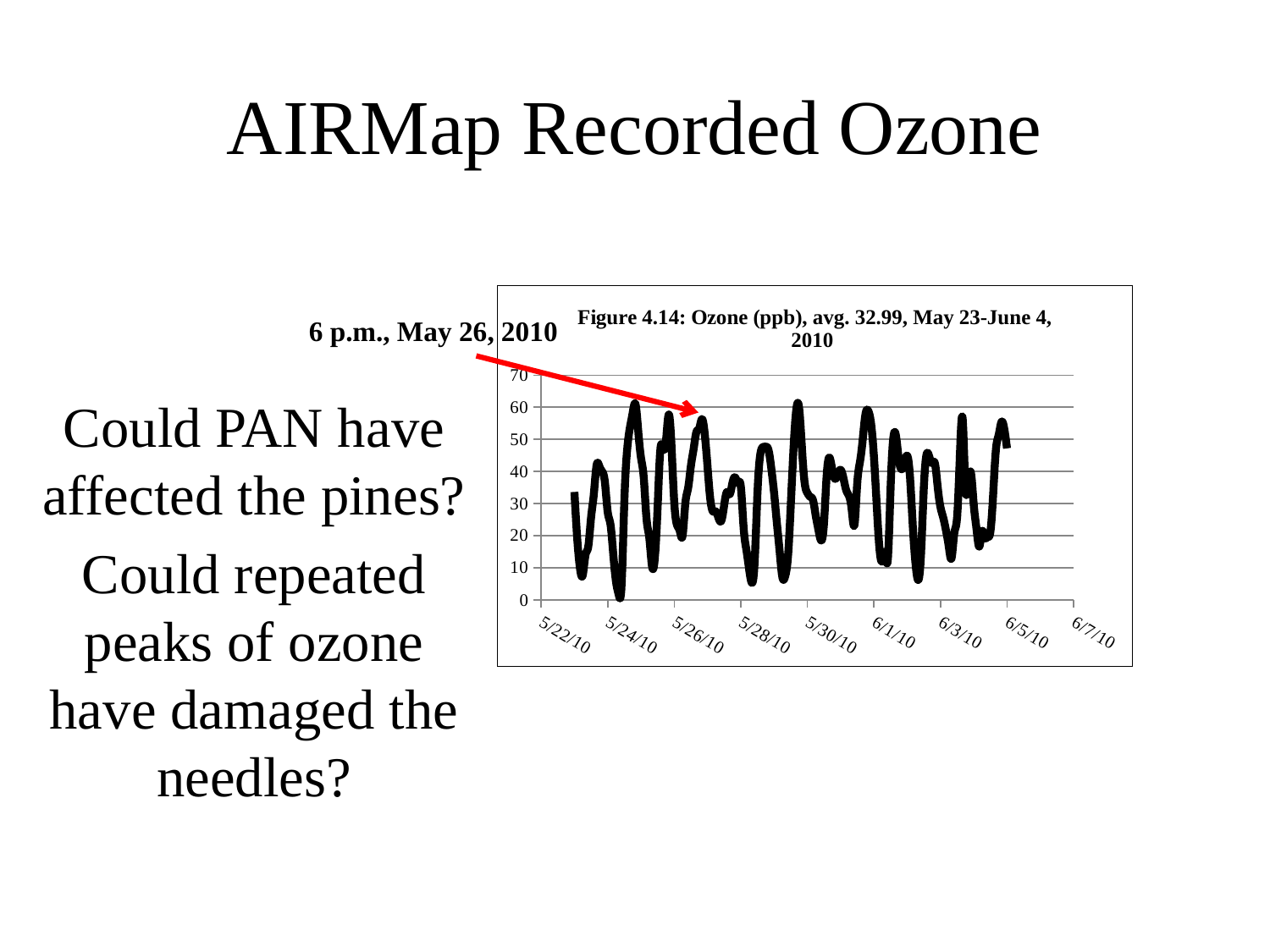
Is the highest ozone peak on the chart greater or less than 50? greater What is the first date label on the x axis? 5/22/10 Does the ozone line show a steady rise, a steady fall, or repeated peaks and dips across the dates? repeated peaks and dips What average ozone value is stated in the chart title? 32.99 What is the highest tick value on the y axis? 70 Does the ozone line ever rise above the 70 tick on the y axis? No What kind of chart is shown on the slide? line chart Is the lowest ozone value on the chart, near 5/24/10, greater or less than 10? less How many date labels are shown along the x axis? 9 What is the last date label on the x axis? 6/7/10 What is the title of the chart? Figure 4.14: Ozone (ppb), avg. 32.99, May 23-June 4, 2010 How many data series are plotted on the chart? 1